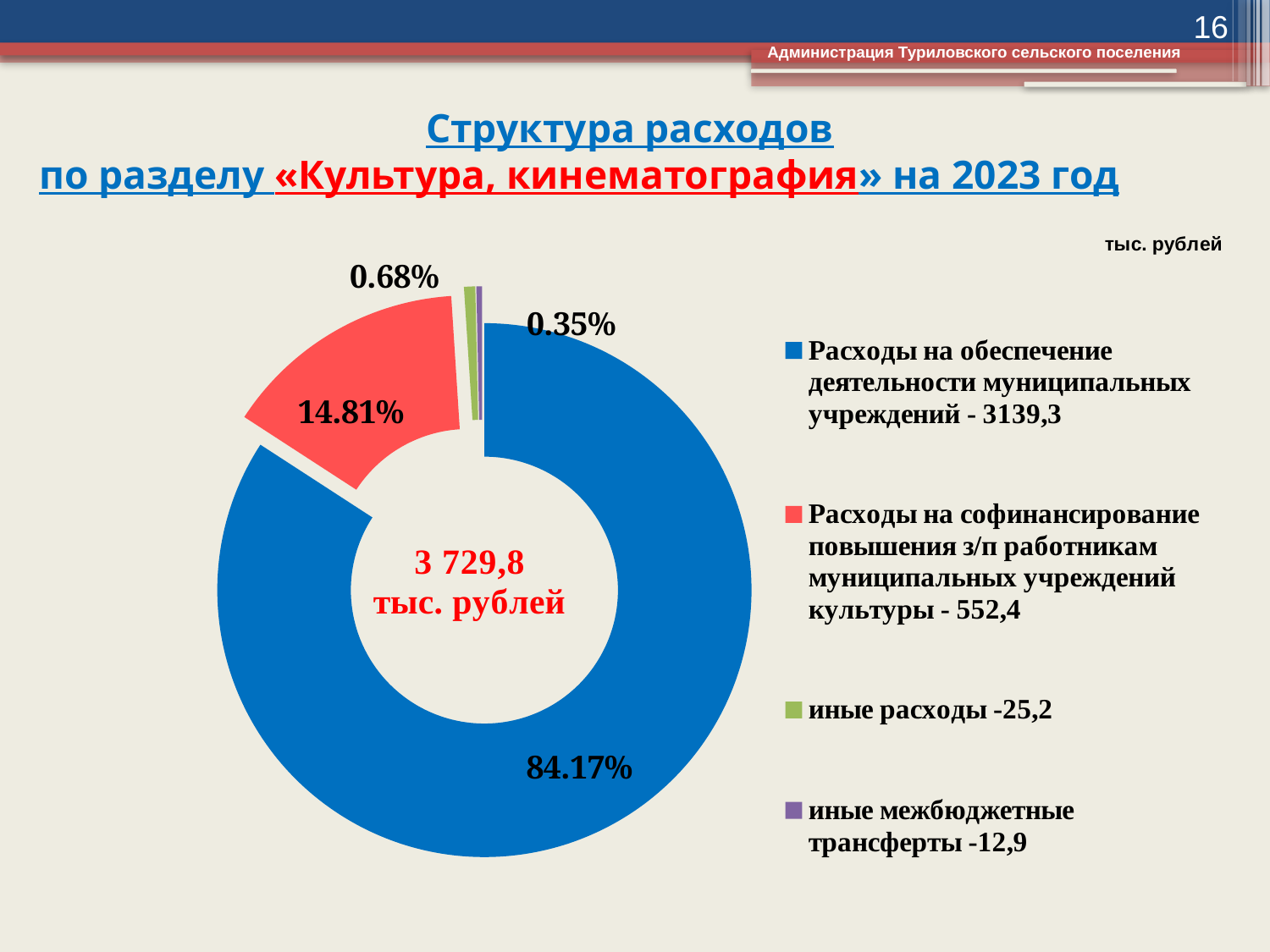
What share of the chart does the slice for «иные межбюджетные трансферты» represent? 0.35% What total amount is shown in the centre of the chart? 3 729,8 тыс. рублей What value (тыс. рублей) is given in the legend for «Расходы на обеспечение деятельности муниципальных учреждений»? 3139,3 What share of the chart does the slice for «Расходы на обеспечение деятельности муниципальных учреждений» represent? 84.17% What kind of chart is shown on the slide? Doughnut (pie) chart What share of the chart does the slice for «иные расходы» represent? 0.68% How many categories does the legend list? 4 Which category has the largest slice of the chart? Расходы на обеспечение деятельности муниципальных учреждений What value (тыс. рублей) is given in the legend for «иные межбюджетные трансферты»? 12,9 Which is larger: the slice for «иные расходы» or the slice for «иные межбюджетные трансферты»? иные расходы Which category has the smallest slice of the chart? иные межбюджетные трансферты